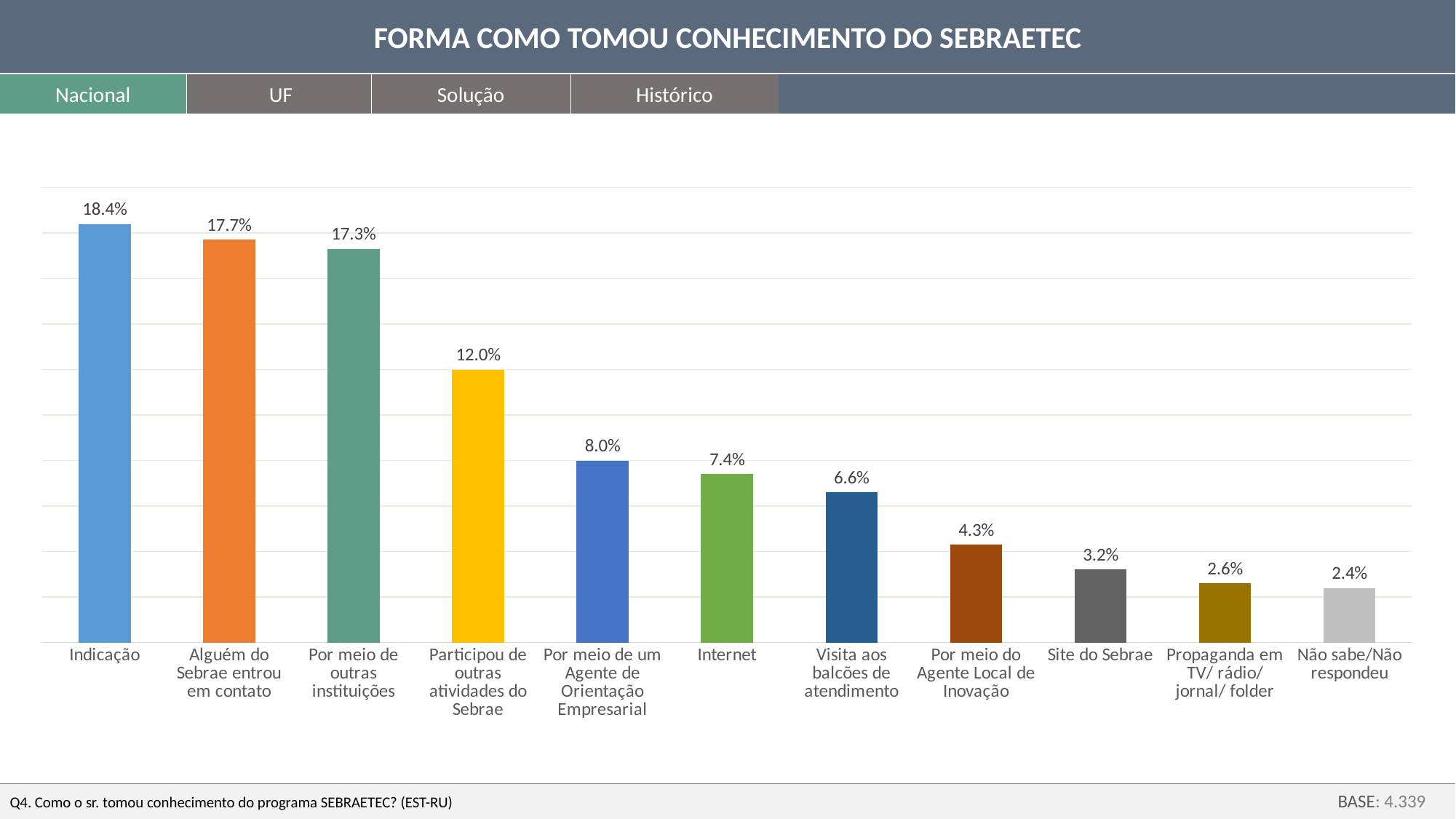
What is the value for Internet? 7.4% Which category has the highest value? Indicação Which is larger, the value for Internet or the value for Visita aos balcões de atendimento? Internet How many categories are shown in the chart? 11 What is the difference between the values for Indicação and Participou de outras atividades do Sebrae? 6.4% Which category has the lowest value? Não sabe/Não respondeu What is the value for Site do Sebrae? 3.2% What is the value for Indicação? 18.4% What kind of chart is shown on the slide? Bar chart What is the difference between the values for Propaganda em TV/ rádio/ jornal/ folder and Não sabe/Não respondeu? 0.2% Do the values rise or fall from left to right along the x axis? Fall What is the title of the chart? FORMA COMO TOMOU CONHECIMENTO DO SEBRAETEC